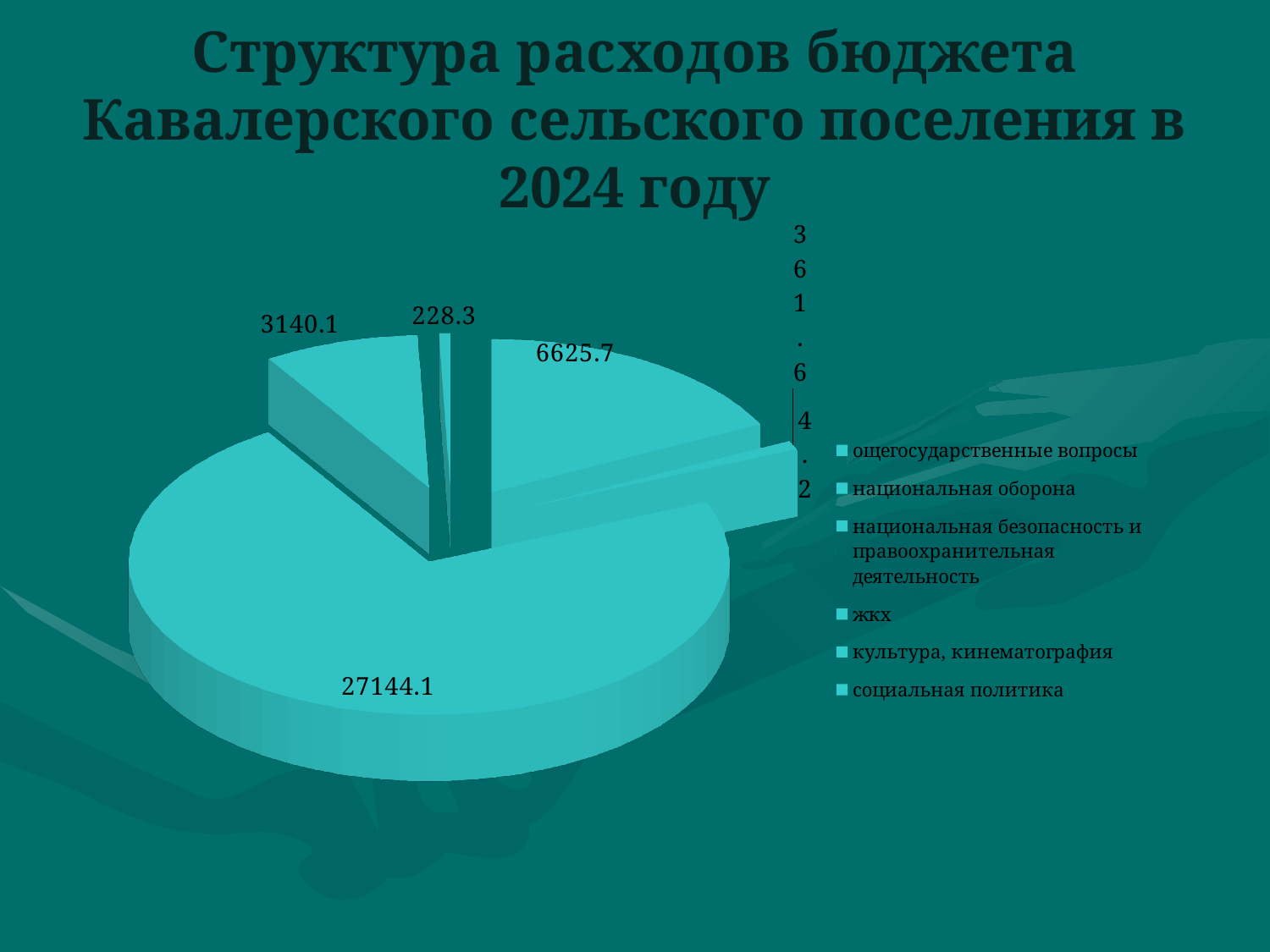
How many data labels are printed on the pie chart? 6 What is the first entry listed in the chart's legend? ощегосударственные вопросы What is the title of the chart on the slide? Структура расходов бюджета Кавалерского сельского поселения в 2024 году Which labelled value is larger, 6625.7 or 3140.1? 6625.7 Which labelled value is larger, 361.6 or 228.3? 361.6 What is the difference between the two largest labelled values, 27144.1 and 6625.7? 20518.4 What is the difference between the labelled values 3140.1 and 228.3? 2911.8 What is the sum of all the values labelled on the pie chart? 37504.0 What kind of chart is shown on the slide? pie chart What is the smallest value labelled on the pie chart? 4.2 What is the largest value labelled on the pie chart? 27144.1 How many entries does the chart's legend list? 6